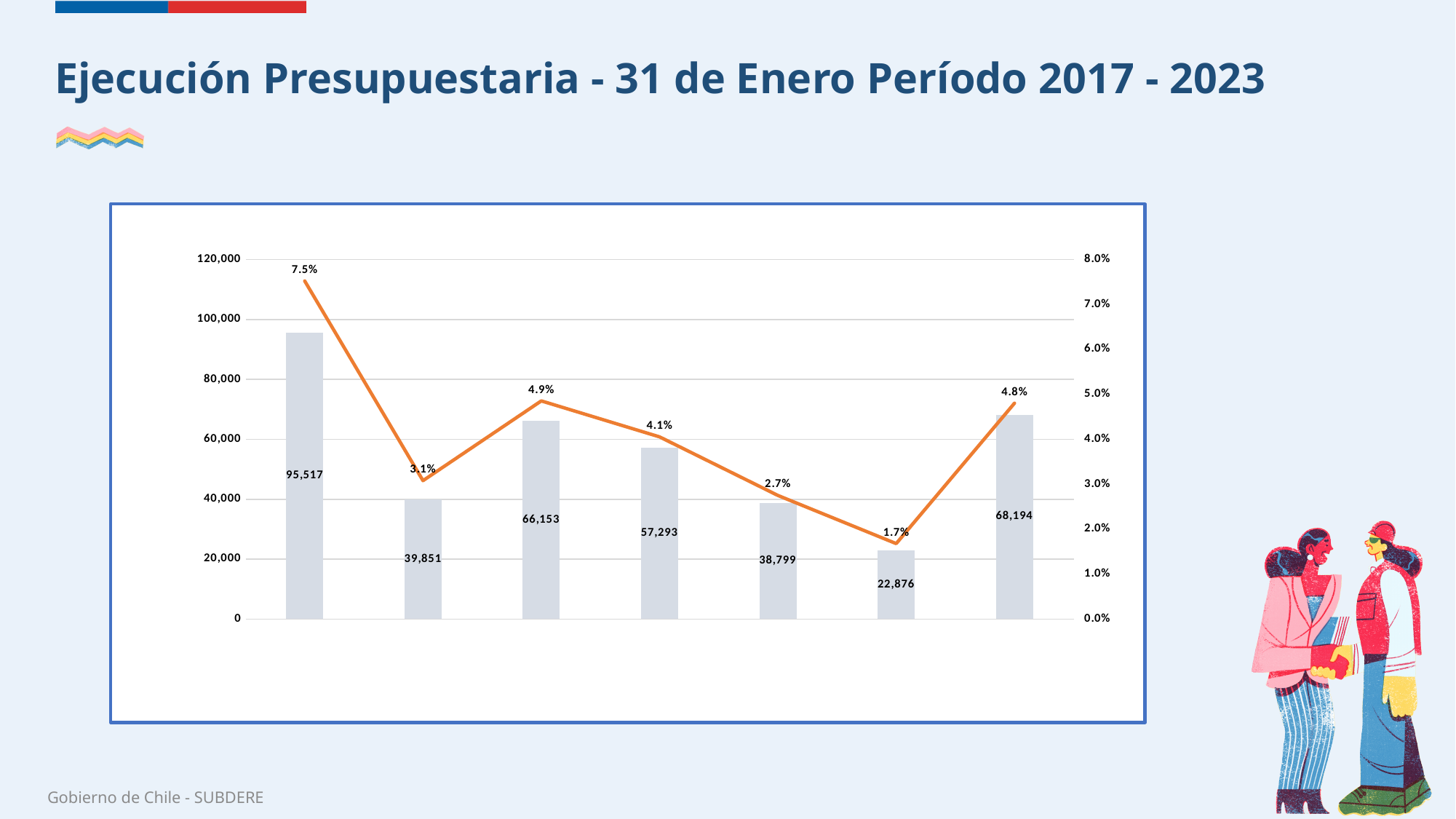
What is the lowest bar value shown on the chart? 22,876 What is the value of the last (rightmost) bar? 68,194 Which bar has the highest value, and what is it? The first bar, 95,517 What is the highest percentage shown on the line? 7.5% What is the maximum value shown on the right-hand axis? 8.0% What percentage does the line show at the sixth point from the left? 1.7% Which is larger, the third bar or the fourth bar? The third bar (66,153) What is the difference between the first bar (95,517) and the second bar (39,851)? 55,666 Does the line rise or fall between the first and second points? Fall What kind of chart is shown on the slide? A combined bar and line chart What is the value of the first (leftmost) bar? 95,517 How many bars are plotted on the chart? 7